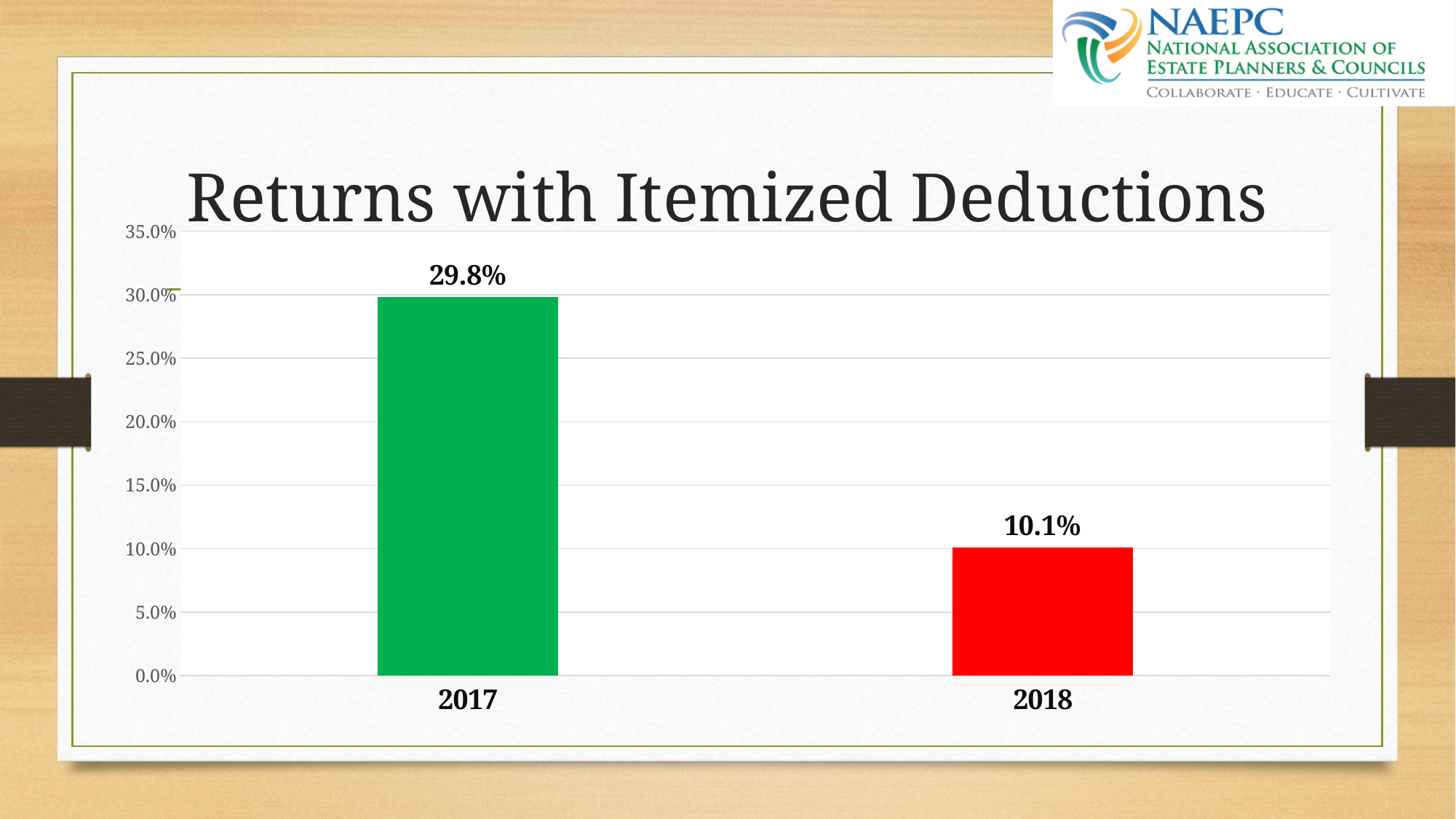
What is the value for 2018? 10.1% What is the title of the chart? Returns with Itemized Deductions How many categories are shown on the x axis? 2 What is the difference between the 2017 and 2018 values? 19.7% Is the value for 2017 greater or less than 25.0%? greater What is the value for 2017? 29.8% What kind of chart is shown on the slide? bar chart Which year has the lowest value? 2018 Do the values rise or fall from 2017 to 2018? fall Which year has the highest value? 2017 Is the value for 2018 greater or less than 15.0%? less Which is larger, the value for 2017 or the value for 2018? 2017